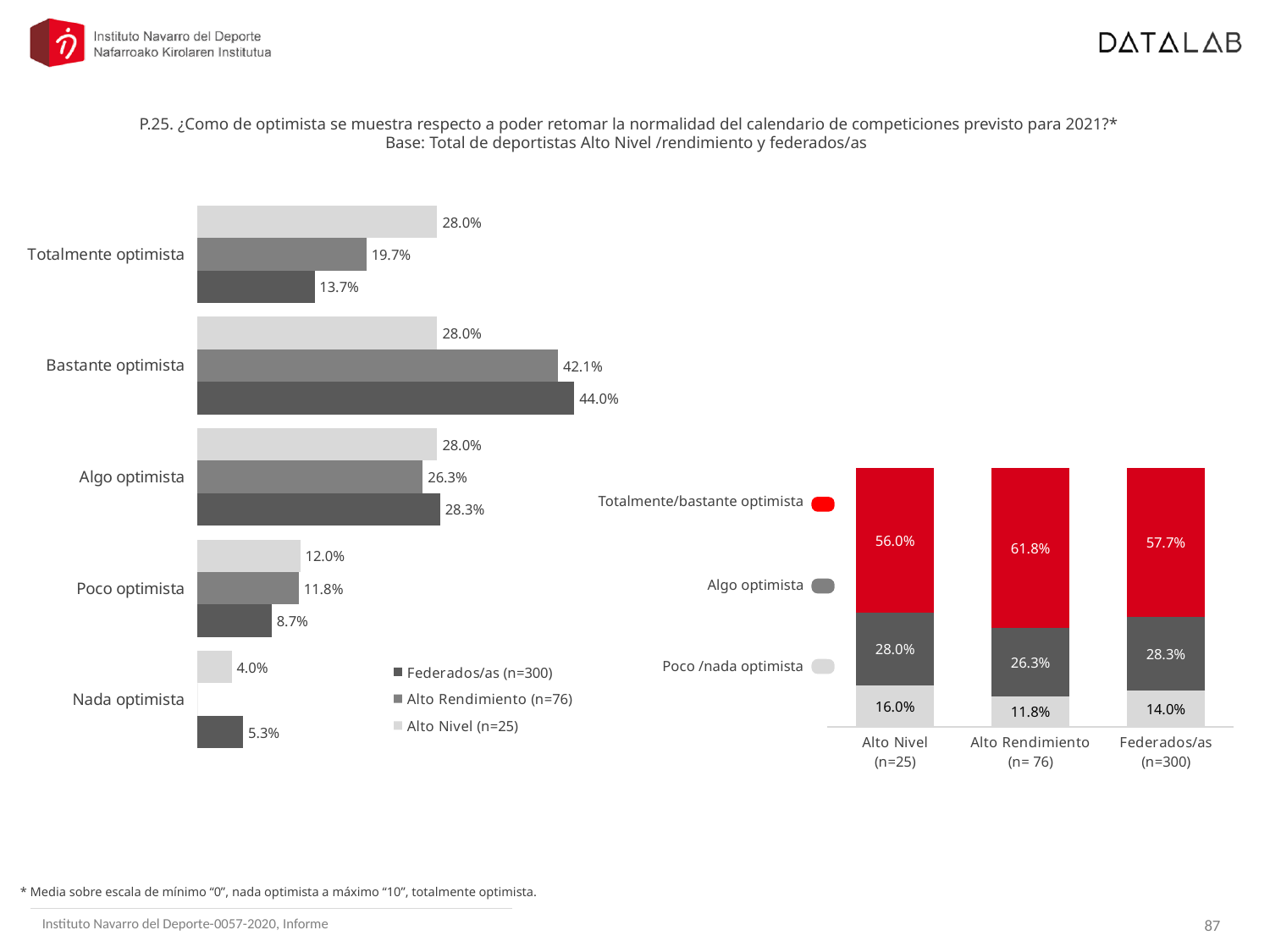
What type of chart is the chart on the right of the slide? Stacked bar chart In the left bar chart, what is the value for Alto Rendimiento (n=76) in the 'Totalmente optimista' category? 19.7% In the left bar chart, what is the value for Federados/as (n=300) in the 'Bastante optimista' category? 44.0% In the left bar chart, what is the difference between the Federados/as (n=300) and Alto Nivel (n=25) values for 'Bastante optimista'? 16.0% In the left bar chart, what is the value for Alto Nivel (n=25) in the 'Poco optimista' category? 12.0% In the left bar chart, which category has the lowest value for Alto Nivel (n=25)? Nada optimista How many series does the legend of the left bar chart list? 3 In the left bar chart, which is larger for 'Totalmente optimista': Alto Nivel (n=25) or Federados/as (n=300)? Alto Nivel (n=25) In the left bar chart, which category has the highest value for Federados/as (n=300)? Bastante optimista How many categories are shown on the left bar chart? 5 In the right stacked bar chart, what is the 'Totalmente/bastante optimista' share for Alto Rendimiento (n=76)? 61.8% In the right stacked bar chart, what is the 'Poco /nada optimista' value for Federados/as (n=300)? 14.0%